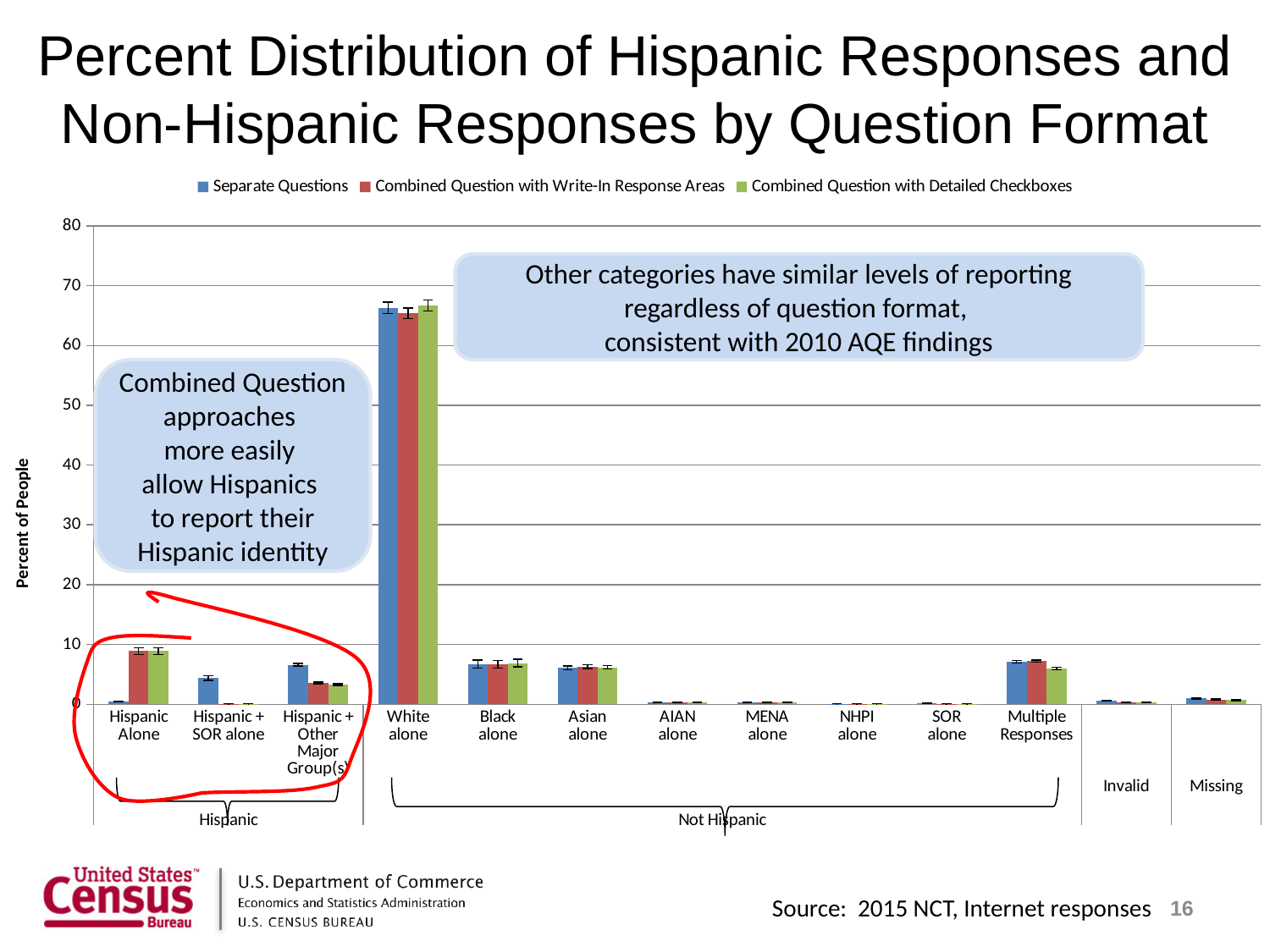
What kind of chart is shown on the slide? Bar chart For Hispanic + SOR alone, which is larger: Separate Questions or Combined Question with Detailed Checkboxes? Separate Questions How many series does the legend list? 3 For Hispanic + Other Major Group(s), which is larger: Separate Questions or Combined Question with Write-In Response Areas? Separate Questions Is the value for White alone under Separate Questions greater or less than 60? greater What source is cited for the chart data? 2015 NCT, Internet responses What is the label on the vertical axis of the chart? Percent of People Is the value for Hispanic Alone under Separate Questions greater or less than 10? less Is the value for White alone under Combined Question with Detailed Checkboxes greater or less than 70? less How many categories are shown along the x axis of the chart? 13 For Hispanic Alone, which is larger: Separate Questions or Combined Question with Write-In Response Areas? Combined Question with Write-In Response Areas Which category has the highest bars in the chart? White alone